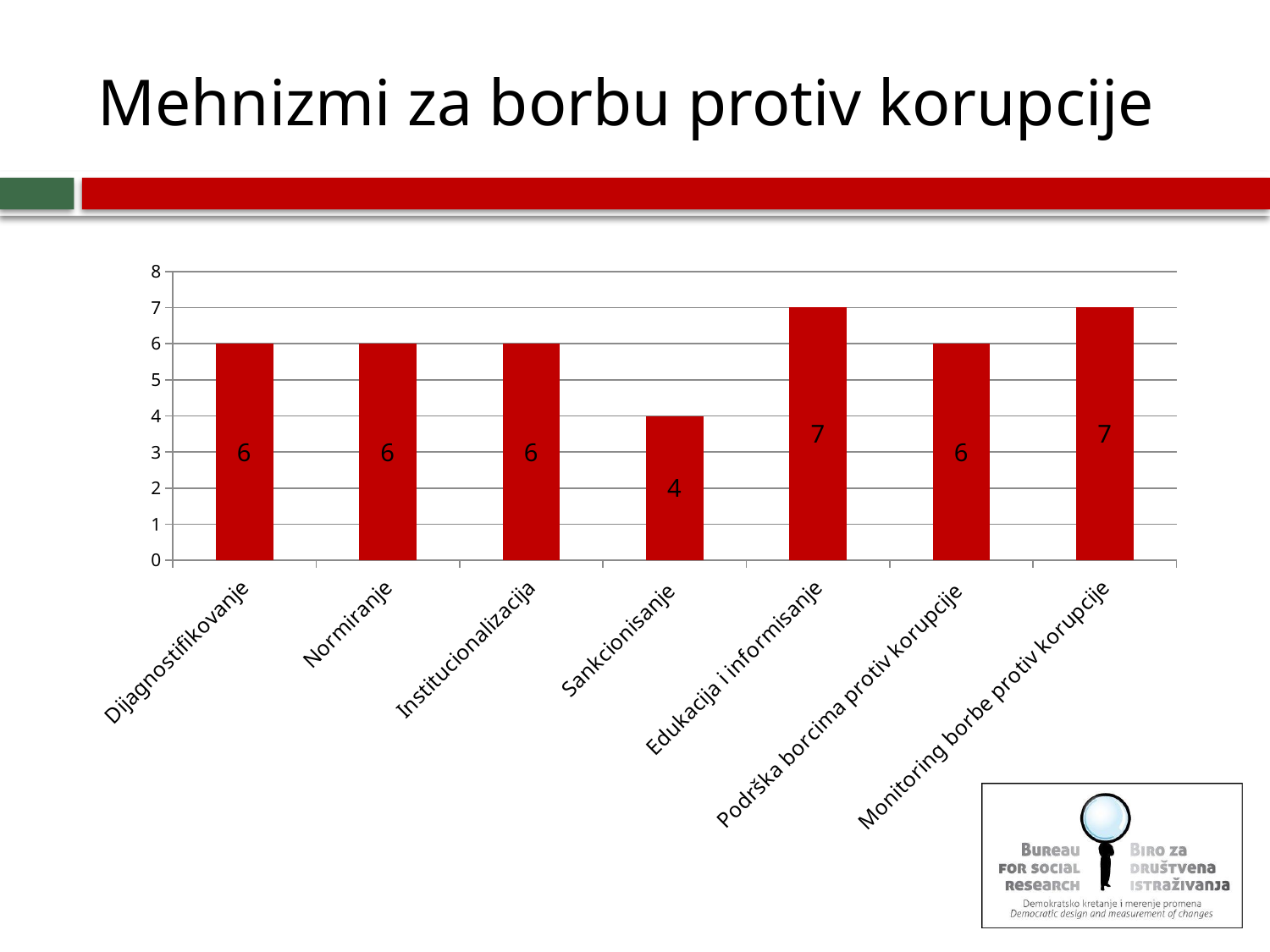
What is the value for Normiranje? 6 What is the difference between the values for Monitoring borbe protiv korupcije and Institucionalizacija? 1 What is the value for Edukacija i informisanje? 7 Which category has the lowest value? Sankcionisanje What is the title of the slide? Mehnizmi za borbu protiv korupcije What is the difference between the values for Edukacija i informisanje and Sankcionisanje? 3 Which is larger, the value for Dijagnostifikovanje or the value for Sankcionisanje? Dijagnostifikovanje Is the value for Sankcionisanje greater or less than 5? less How many categories are shown on the x axis? 7 What is the value for Sankcionisanje? 4 What is the value for Podrška borcima protiv korupcije? 6 What kind of chart is shown on the slide? bar chart